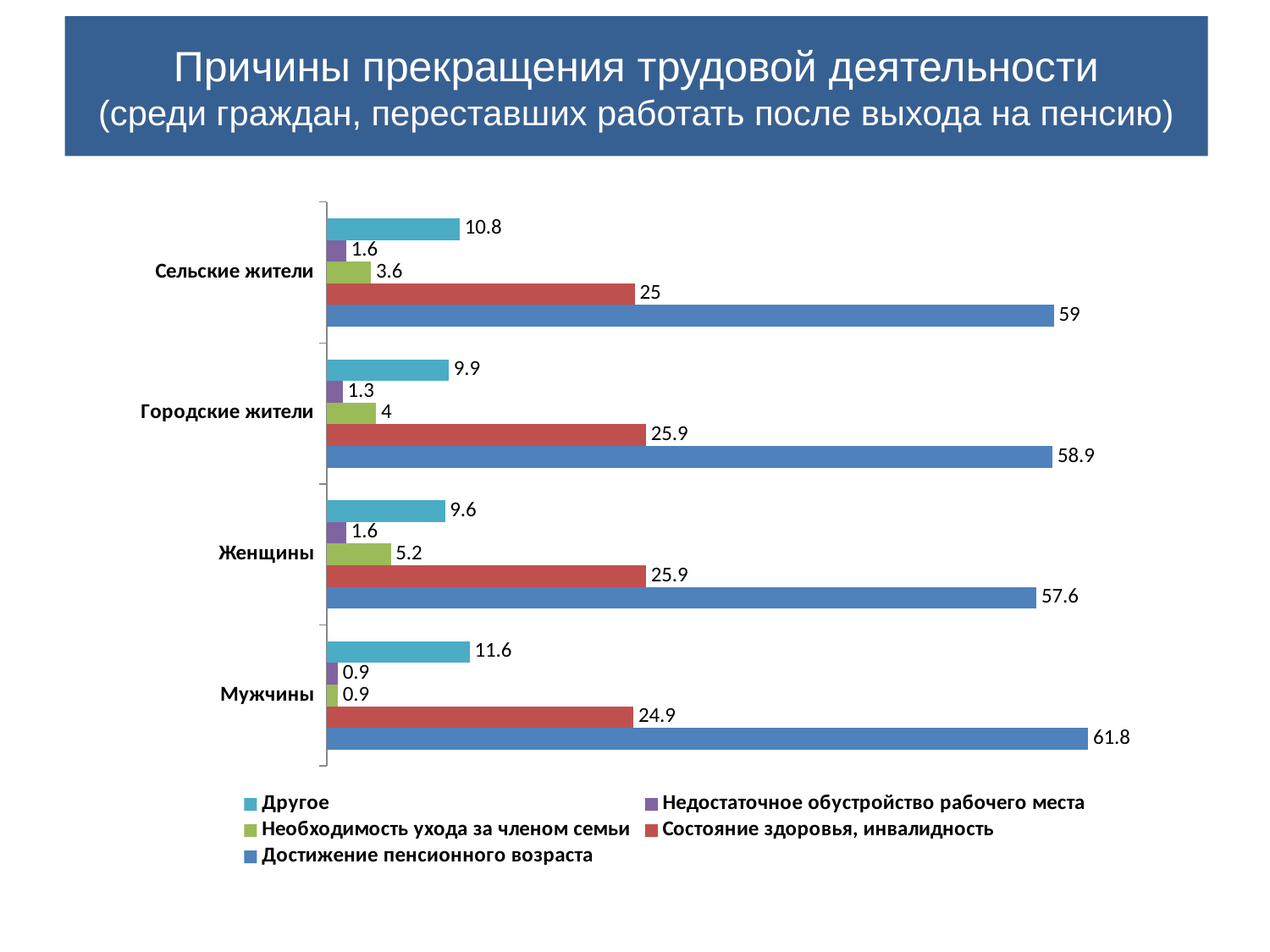
How many series does the legend list? 5 What is the value for "Необходимость ухода за членом семьи" among Женщины? 5.2 What is the value for "Другое" among Сельские жители? 10.8 Which is larger: the "Другое" value for Мужчины or for Женщины? Мужчины What is the value for "Состояние здоровья, инвалидность" among Городские жители? 25.9 Which category has the highest value for "Достижение пенсионного возраста"? Мужчины Which series is shown in red? Состояние здоровья, инвалидность What kind of chart is shown on the slide? Bar chart How many categories are shown on the vertical axis? 4 Which category has the lowest value for "Необходимость ухода за членом семьи"? Мужчины What is the value for "Достижение пенсионного возраста" among Мужчины? 61.8 What is the difference between the "Достижение пенсионного возраста" values for Мужчины and Женщины? 4.2